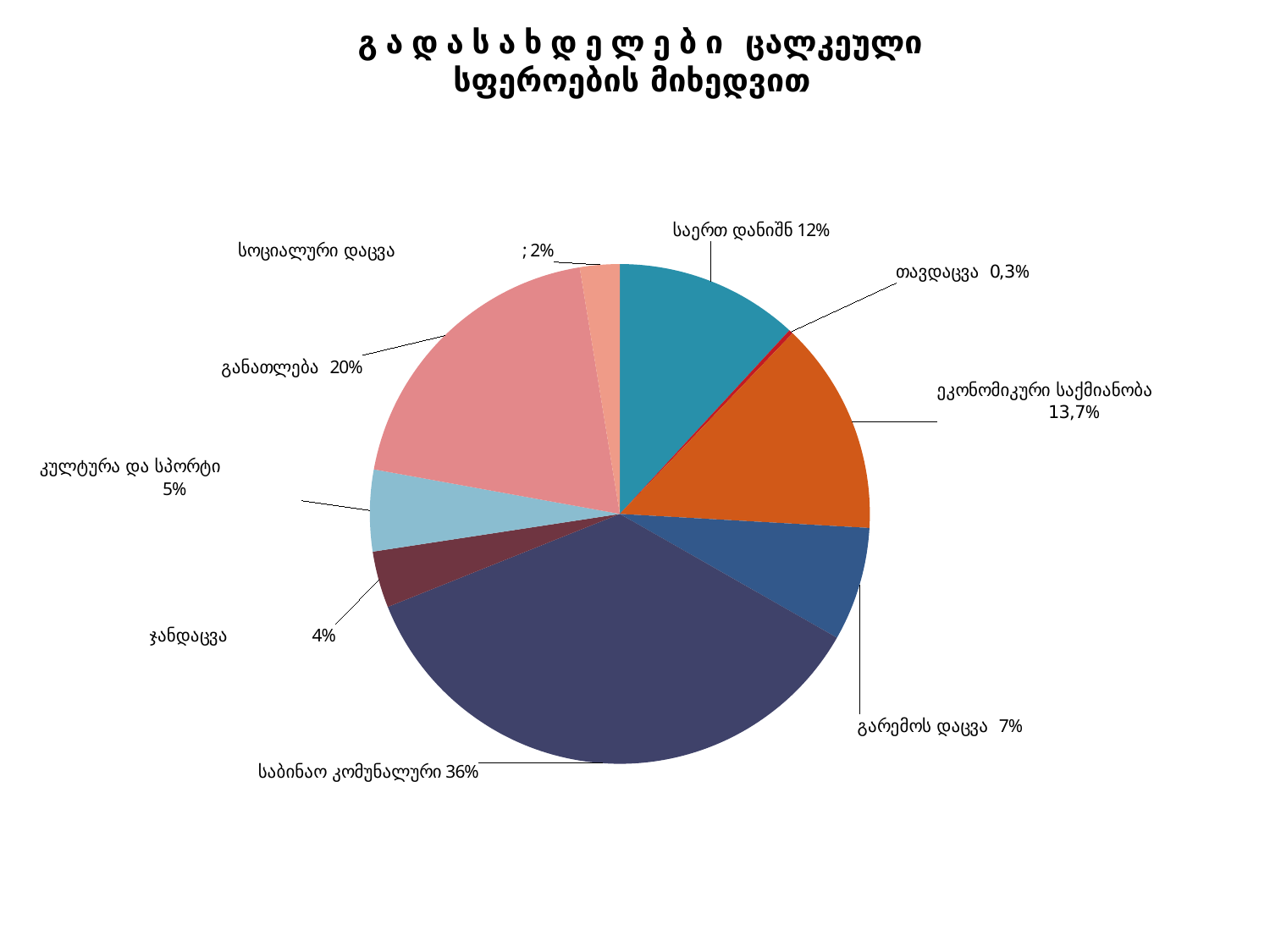
What is the value shown for განათლება? 20% Which category has the smallest slice of the pie? თავდაცვა What kind of chart is shown on the slide? pie chart What is the difference between the shares of განათლება and საერთო დანიშნ? 8% What is the title of the chart? გადასახდელები ცალკეული სფეროების მიხედვით What share of the pie does საბინაო კომუნალური have? 36% What is the value shown for ეკონომიკური საქმიანობა? 13,7% Which is larger, the share for გარემოს დაცვა or the share for კულტურა და სპორტი? გარემოს დაცვა What is the value shown for ჯანდაცვა? 4% What is the value shown for თავდაცვა? 0,3% Which category has the largest slice of the pie? საბინაო კომუნალური How many slices does the pie chart have? 9